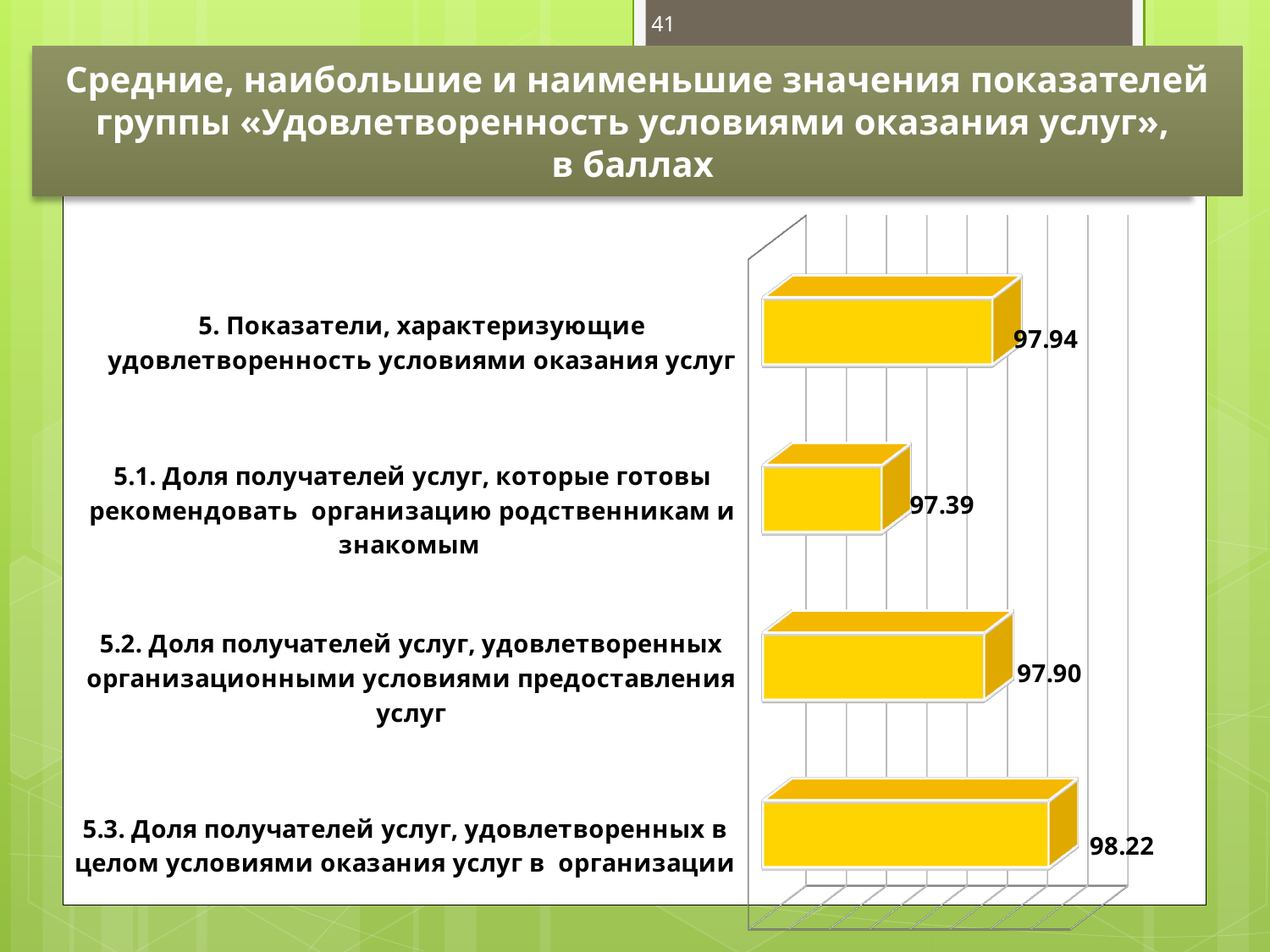
Which is larger, the value for indicator 5.3 or the value for indicator 5.1? 5.3 Which indicator has the lowest value on the chart? 5.1 How many bars (categories) are shown on the chart? 4 What is the value for indicator 5.3 (share of service recipients satisfied overall with the conditions of service provision in the organisation)? 98.22 What is the difference between the values for indicator 5.3 and indicator 5.1? 0.83 Which indicator has the highest value on the chart? 5.3 What kind of chart is shown on the slide? Bar chart What colour are the bars on the chart? Yellow What is the value for indicator 5.2 (share of service recipients satisfied with the organisational conditions of service provision)? 97.90 What is the value for indicator 5.1 (share of service recipients willing to recommend the organisation to relatives and friends)? 97.39 What is the difference between the values for indicator 5 and indicator 5.2? 0.04 What is the value for indicator 5 (indicators characterising satisfaction with the conditions of service provision)? 97.94